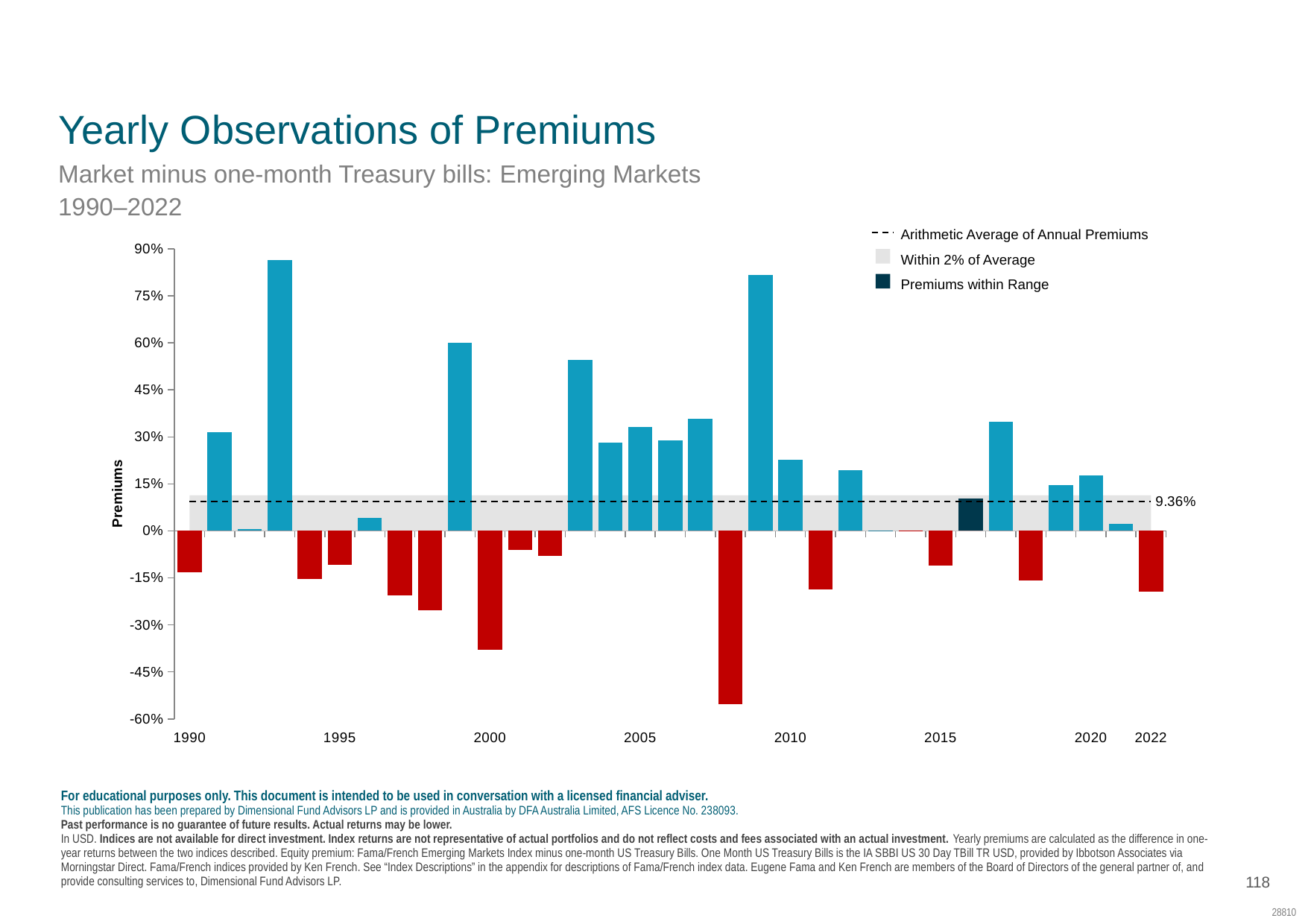
Is the premium for 2008 greater or less than -45%? less Which year's bar is shown in the dark colour for 'Premiums within Range'? 2016 Is the premium for 2000 greater or less than -30%? less What kind of chart is shown on the slide? Bar chart Which year has the lowest premium? 2008 What is the arithmetic average of annual premiums shown by the dashed line? 9.36% How many entries does the legend list? 3 Is the premium for 1993 greater or less than 75%? greater Which year has the highest premium? 1993 Which year has the larger premium, 2000 or 2008? 2000 Which year has the larger premium, 1999 or 2003? 1999